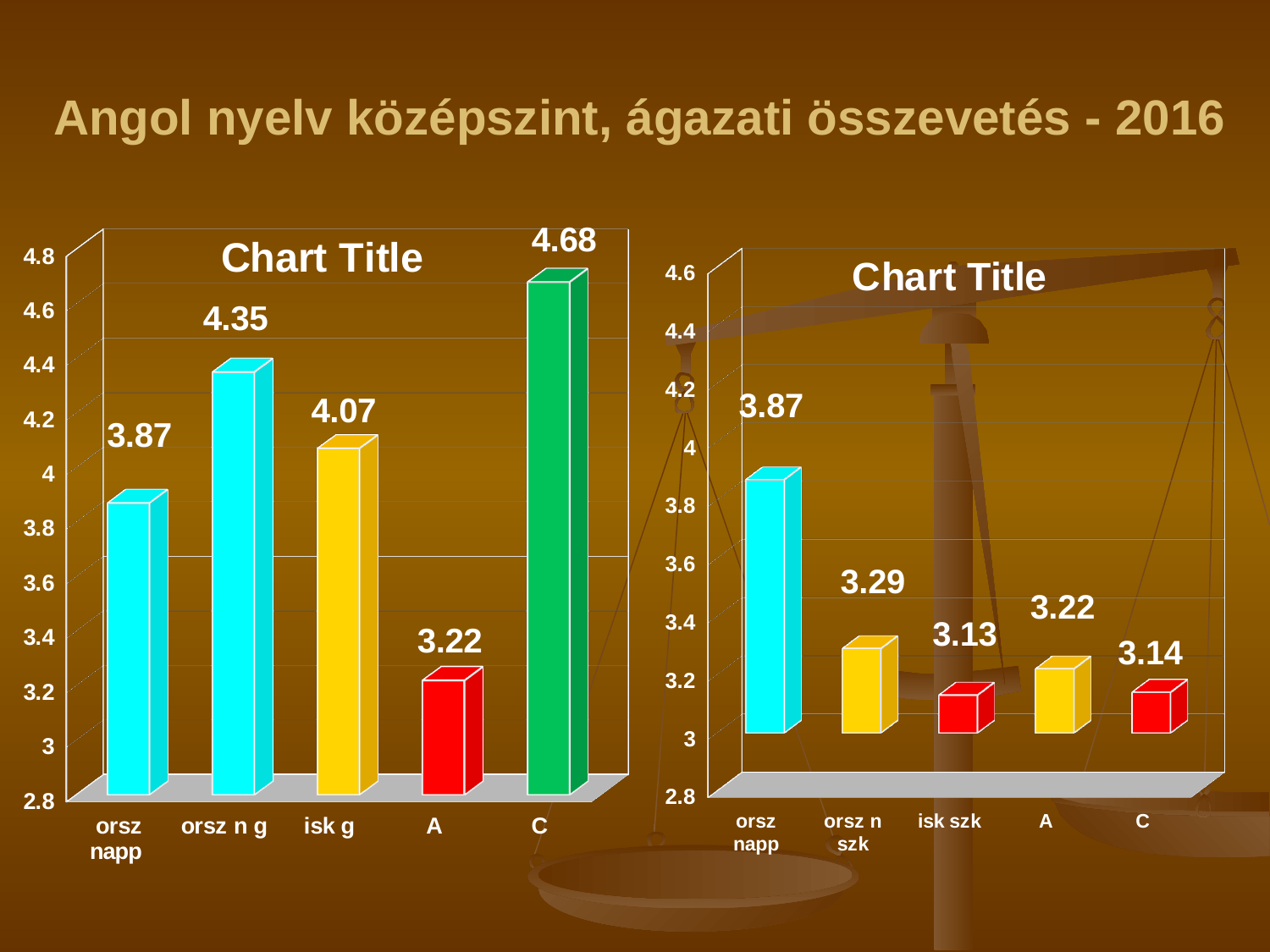
In the left chart, what is the value for C? 4.68 In the right chart, which category has the lowest value? isk szk In the right chart, which is larger, the value for A or the value for C? A In the right chart, what is the value for orsz n szk? 3.29 In the left chart, what is the difference between the values for C and A? 1.46 In the right chart, what is the value for isk szk? 3.13 How many categories are shown in the right chart? 5 In the right chart, which category has the highest value? orsz napp In the left chart, what is the value for isk g? 4.07 In the left chart, which category has the lowest value? A What type of chart is the left chart? bar chart In the left chart, which category has the highest value? C